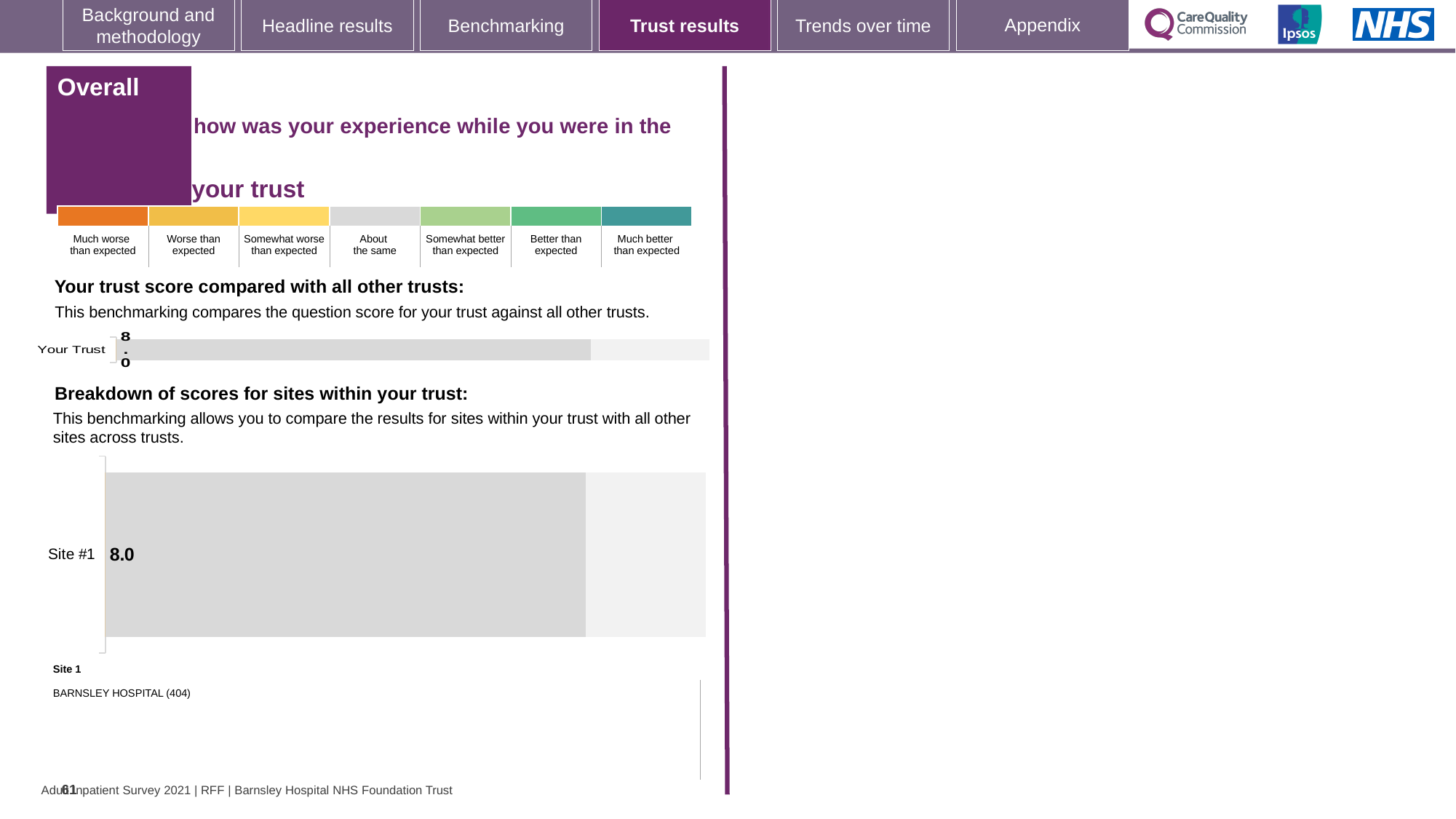
Is the score for Site #1 in the 'Breakdown of scores for sites within your trust' chart the same as the Your Trust score in the chart above it? Yes How many rating categories does the colour key above the charts show, from 'Much worse than expected' to 'Much better than expected'? 7 In the 'Breakdown of scores for sites within your trust' chart, what is the score for Site #1? 8.0 What is the name of the site listed as Site 1 below the 'Breakdown of scores for sites within your trust' chart? BARNSLEY HOSPITAL (404) In the 'Breakdown of scores for sites within your trust' chart, how many sites are plotted? 1 What kind of chart is the 'Your trust score compared with all other trusts' chart? Bar chart In the 'Your trust score compared with all other trusts' chart, what is the score for Your Trust? 8.0 In the 'Your trust score compared with all other trusts' chart, how many categories are plotted? 1 What kind of chart is the 'Breakdown of scores for sites within your trust' chart? Bar chart